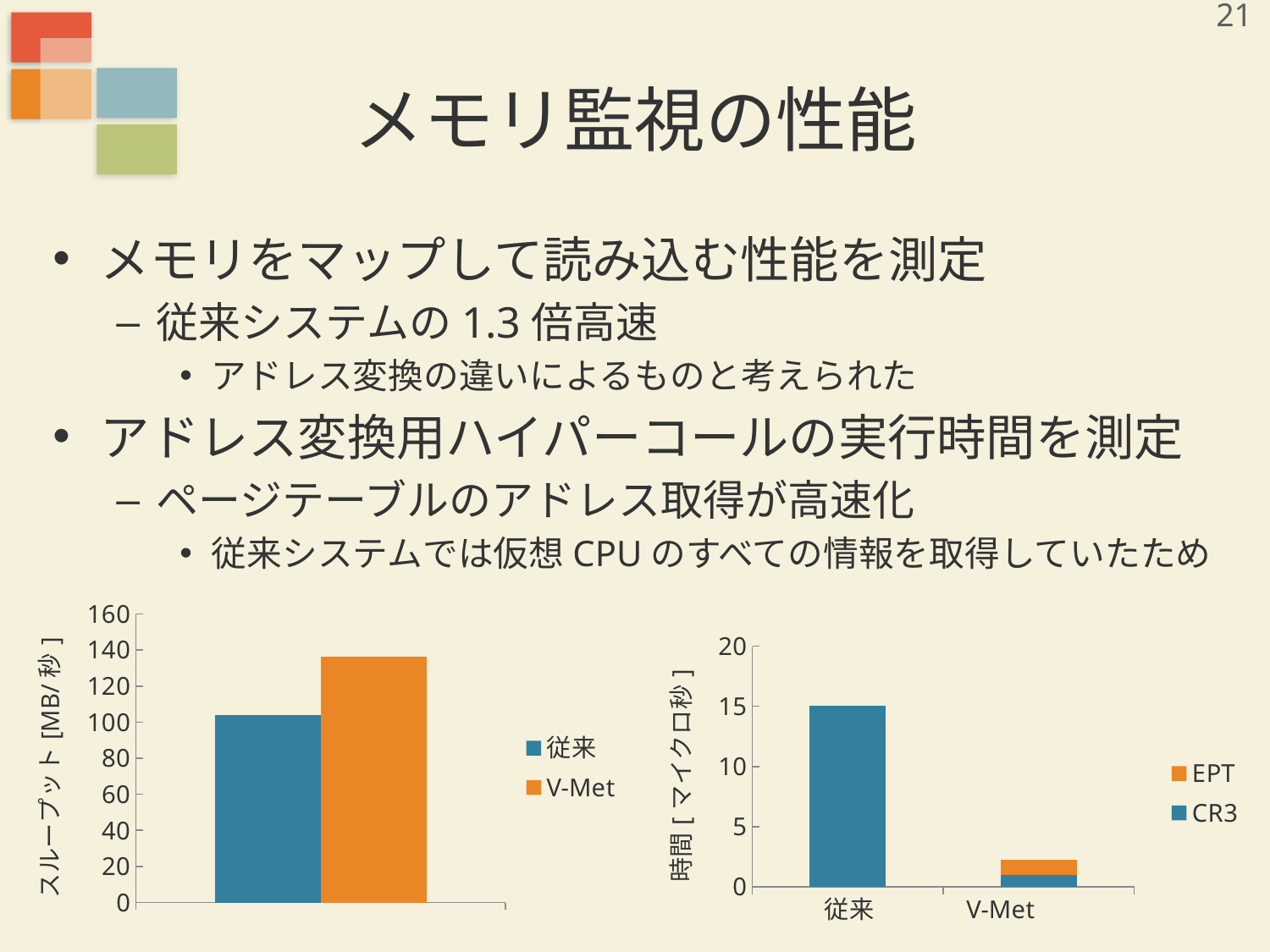
In the right chart, is the total time for V-Met greater or less than 5? less What is the y-axis label of the left chart? スループット [MB/秒] In the left chart, is the throughput for V-Met greater or less than 120? greater How many categories are shown on the x axis of the right chart? 2 What kind of chart is the right chart (time in microseconds)? bar chart What kind of chart is the left chart (throughput)? bar chart How many series does the legend of the right chart list? 2 In the right chart, is the time for 従来 greater or less than 10? greater How many series does the legend of the left chart list? 2 In the right chart, which category has the higher total time, 従来 or V-Met? 従来 In the left chart, which series has the higher throughput, 従来 or V-Met? V-Met